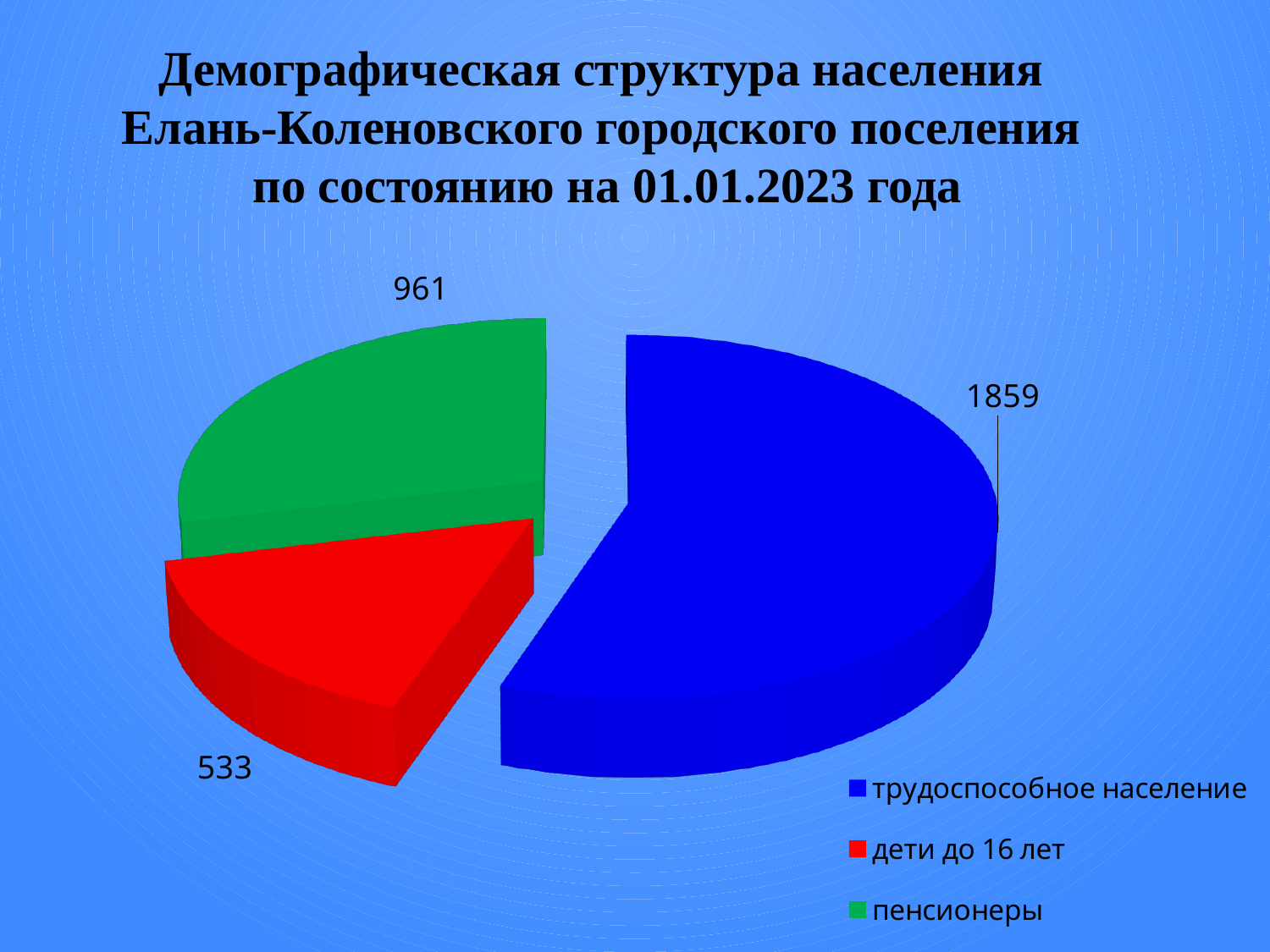
What value is shown for трудоспособное население? 1859 Which category has the largest slice of the pie? трудоспособное население Which is larger, the value for пенсионеры or the value for дети до 16 лет? пенсионеры What is the difference between the values for трудоспособное население and пенсионеры? 898 Which category has the smallest slice of the pie? дети до 16 лет What value is shown for пенсионеры? 961 What is the total of all three values in the pie chart? 3353 Which colour represents пенсионеры in the pie chart? green How many slices does the pie chart have? 3 What is the difference between the values for пенсионеры and дети до 16 лет? 428 What type of chart is shown on the slide? pie chart What value is shown for дети до 16 лет? 533